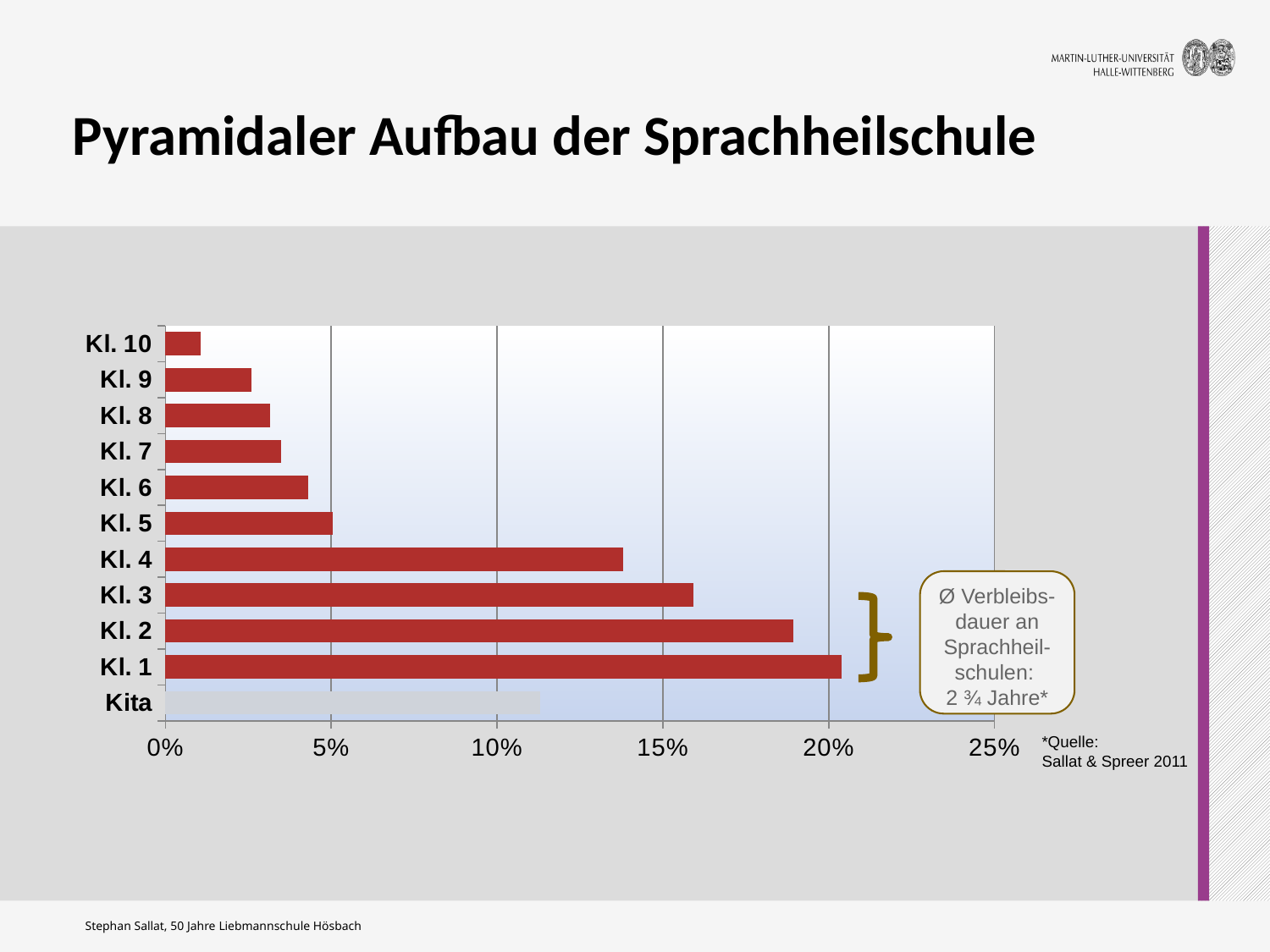
Which category has the lowest value? Kl. 10 Is the value for Kl. 1 greater or less than 15%? greater Is the value for Kl. 4 greater or less than 10%? greater Is the value for Kl. 10 greater or less than 5%? less Do the values decrease or increase going from Kl. 1 up to Kl. 10? decrease Which category's bar is shown in grey rather than red? Kita How many categories are plotted on the chart? 11 Which is larger, the value for Kl. 4 or the value for Kita? Kl. 4 What kind of chart is shown on the slide? bar chart Which category has the highest value? Kl. 1